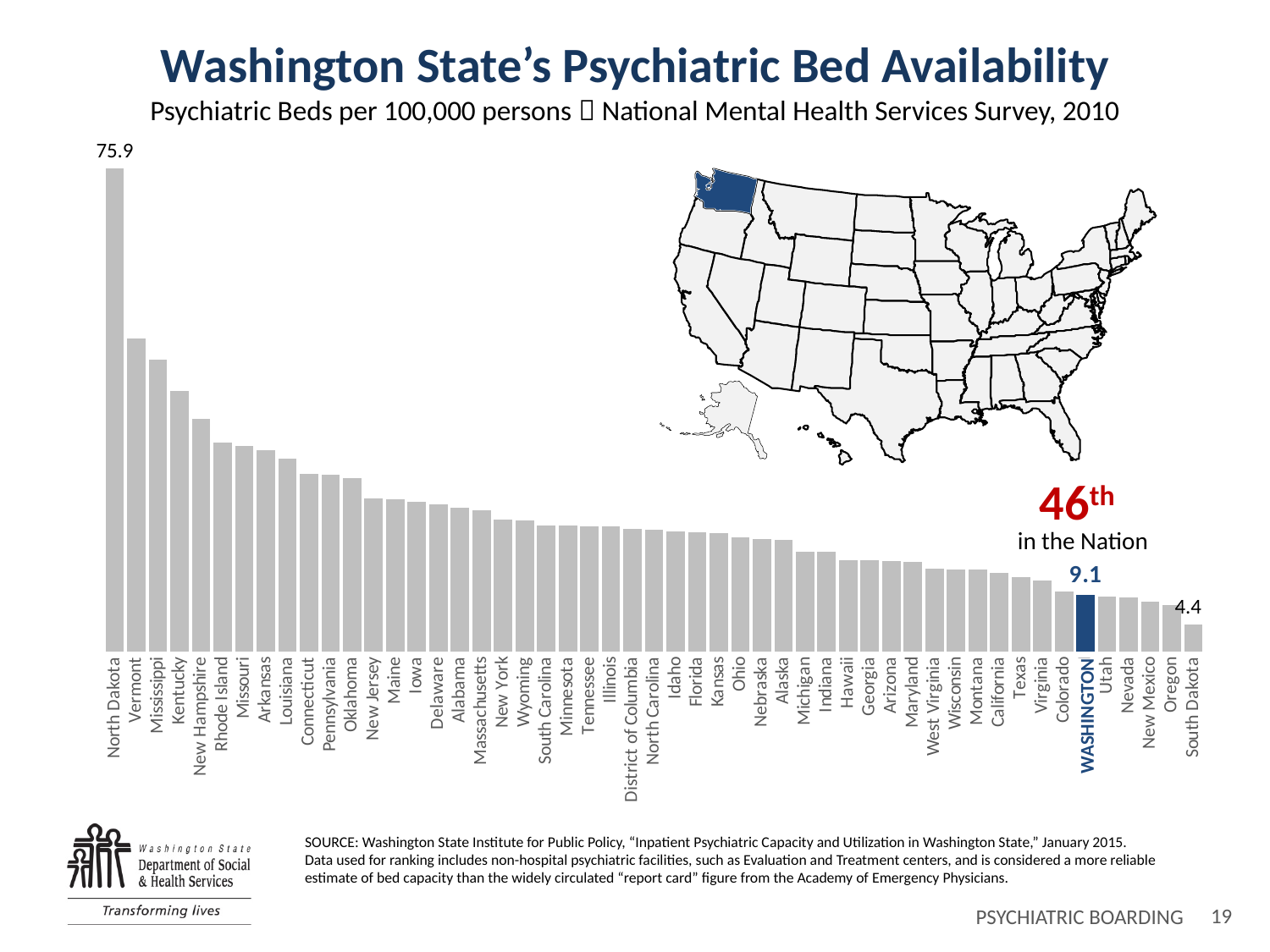
What is the difference between Washington's value and South Dakota's value? 4.7 What type of chart is shown on the slide? Bar chart Which state has the highest number of psychiatric beds per 100,000 persons? North Dakota Do the values rise or fall moving from left to right along the x axis? Fall How many bars (states and districts) are shown in the chart? 51 Which state has the lowest number of psychiatric beds per 100,000 persons? South Dakota Which has a larger value, Vermont or Oregon? Vermont What is the value for South Dakota? 4.4 Where does Washington rank in the nation according to the slide? 46th What is the difference between North Dakota's value and Washington's value? 66.8 What is the value for Washington? 9.1 What is the value for North Dakota? 75.9